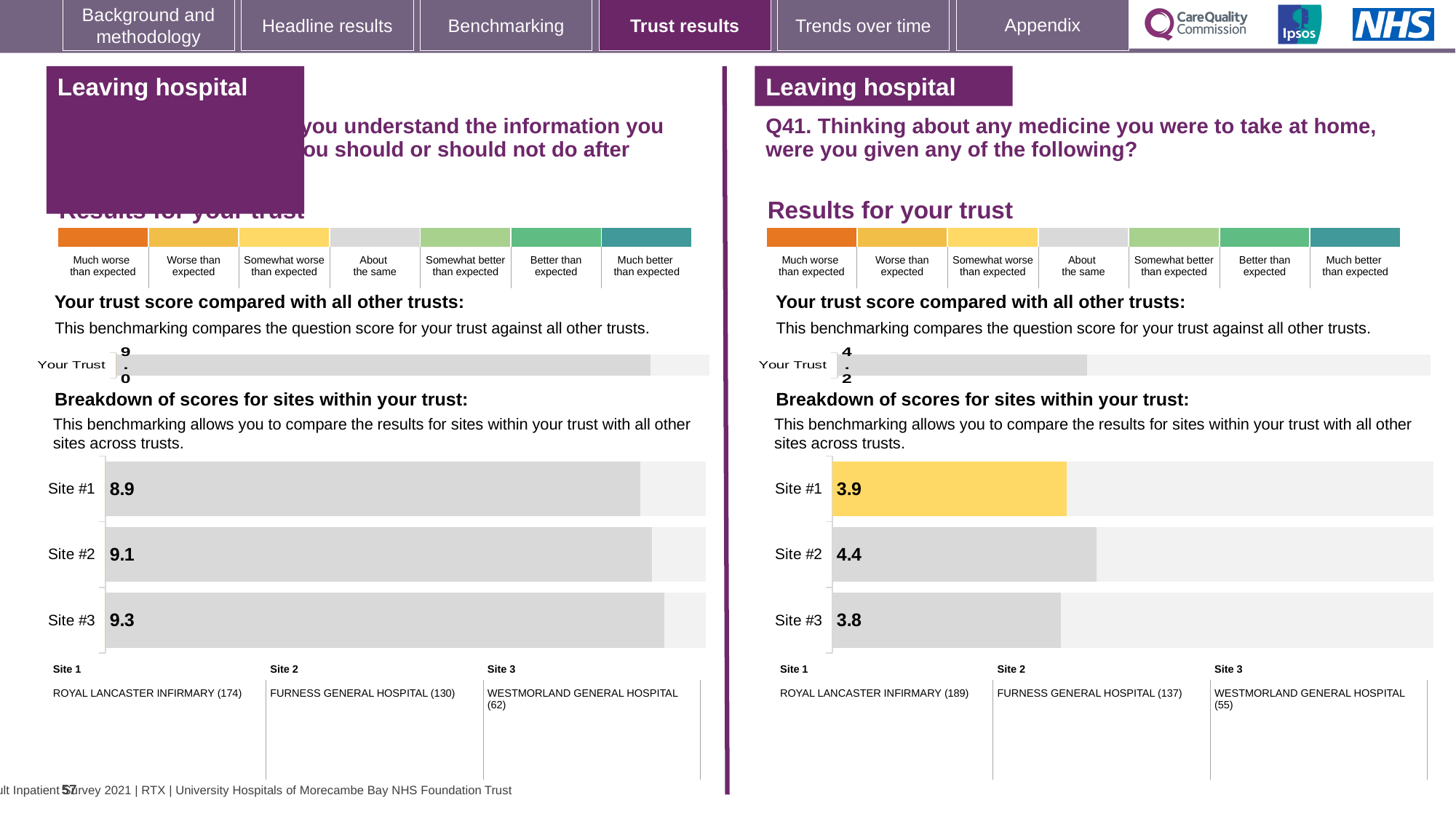
On the Q41 site breakdown chart, what is the score for Site #1? 3.9 What type of chart is used for the site breakdown on the Q41 side of the slide? Bar chart On the left-hand site breakdown chart, which site has the lowest score? Site #1 How many sites are shown on the Q41 site breakdown chart? 3 On the left-hand 'Your Trust' chart, what is the trust score? 9.0 On the Q41 'Your Trust' chart, what is the trust score? 4.2 On the Q41 site breakdown chart, which site has the lowest score? Site #3 On the left-hand site breakdown chart, what is the difference between the scores for Site #3 and Site #1? 0.4 On the Q41 site breakdown chart, which site has the highest score? Site #2 On the left-hand site breakdown chart, which site has the highest score? Site #3 On the Q41 site breakdown chart, what is the difference between the scores for Site #2 and Site #3? 0.6 On the left-hand site breakdown chart, what is the score for Site #2? 9.1